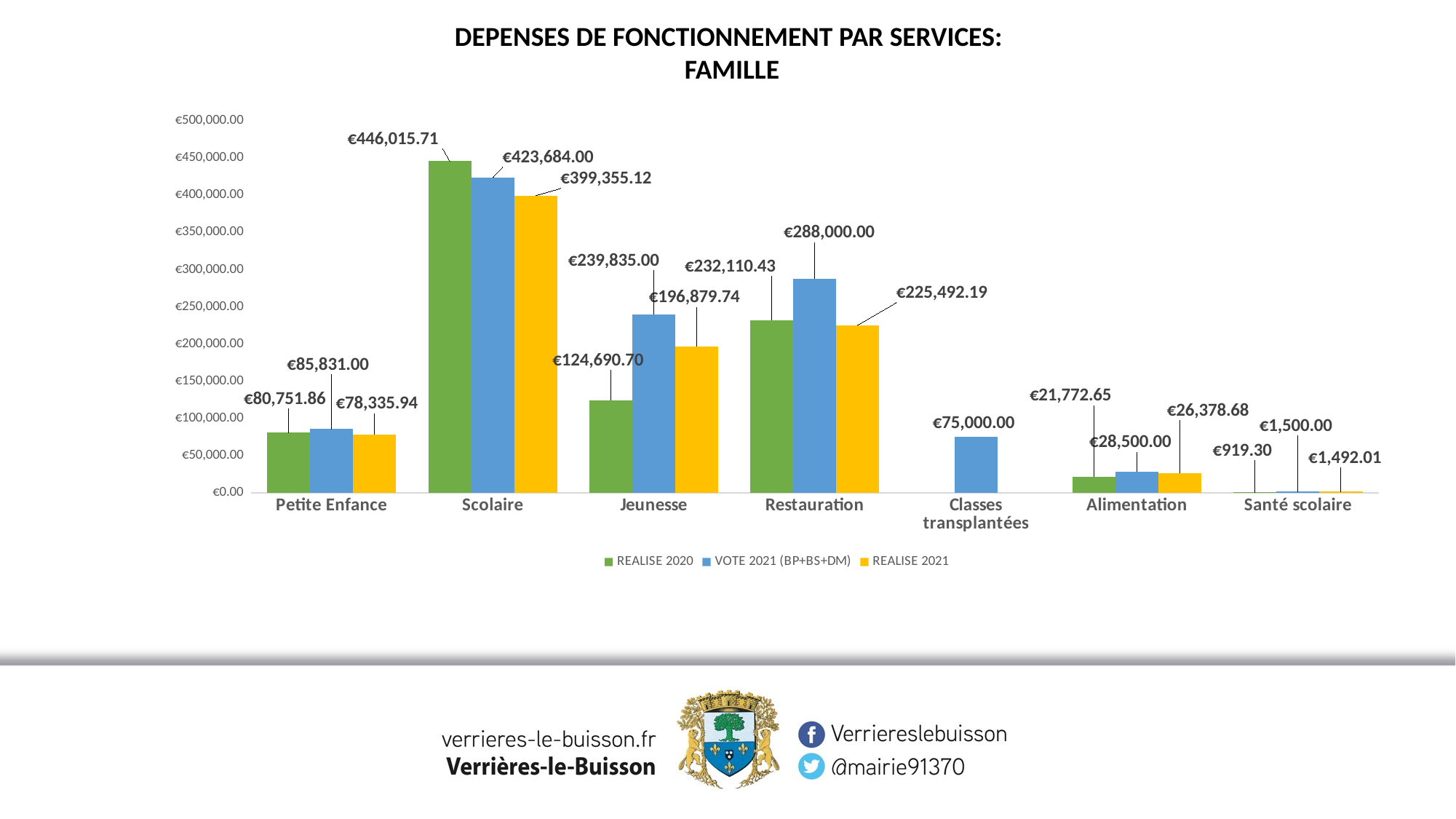
What is the REALISE 2021 value for Jeunesse? €196,879.74 Which category has the highest REALISE 2021 value? Scolaire Which category has the lowest REALISE 2020 value? Santé scolaire How many series does the legend list? 3 Which is larger for Jeunesse: the REALISE 2020 value or the VOTE 2021 (BP+BS+DM) value? VOTE 2021 (BP+BS+DM) How many categories are shown on the x axis? 7 What is the REALISE 2020 value for Scolaire? €446,015.71 What is the difference between the REALISE 2020 and REALISE 2021 values for Scolaire? €46,660.59 What is the VOTE 2021 (BP+BS+DM) value for Classes transplantées? €75,000.00 What kind of chart is shown on the slide? Bar chart What is the VOTE 2021 (BP+BS+DM) value for Restauration? €288,000.00 What is the difference between the VOTE 2021 (BP+BS+DM) and REALISE 2021 values for Restauration? €62,507.81